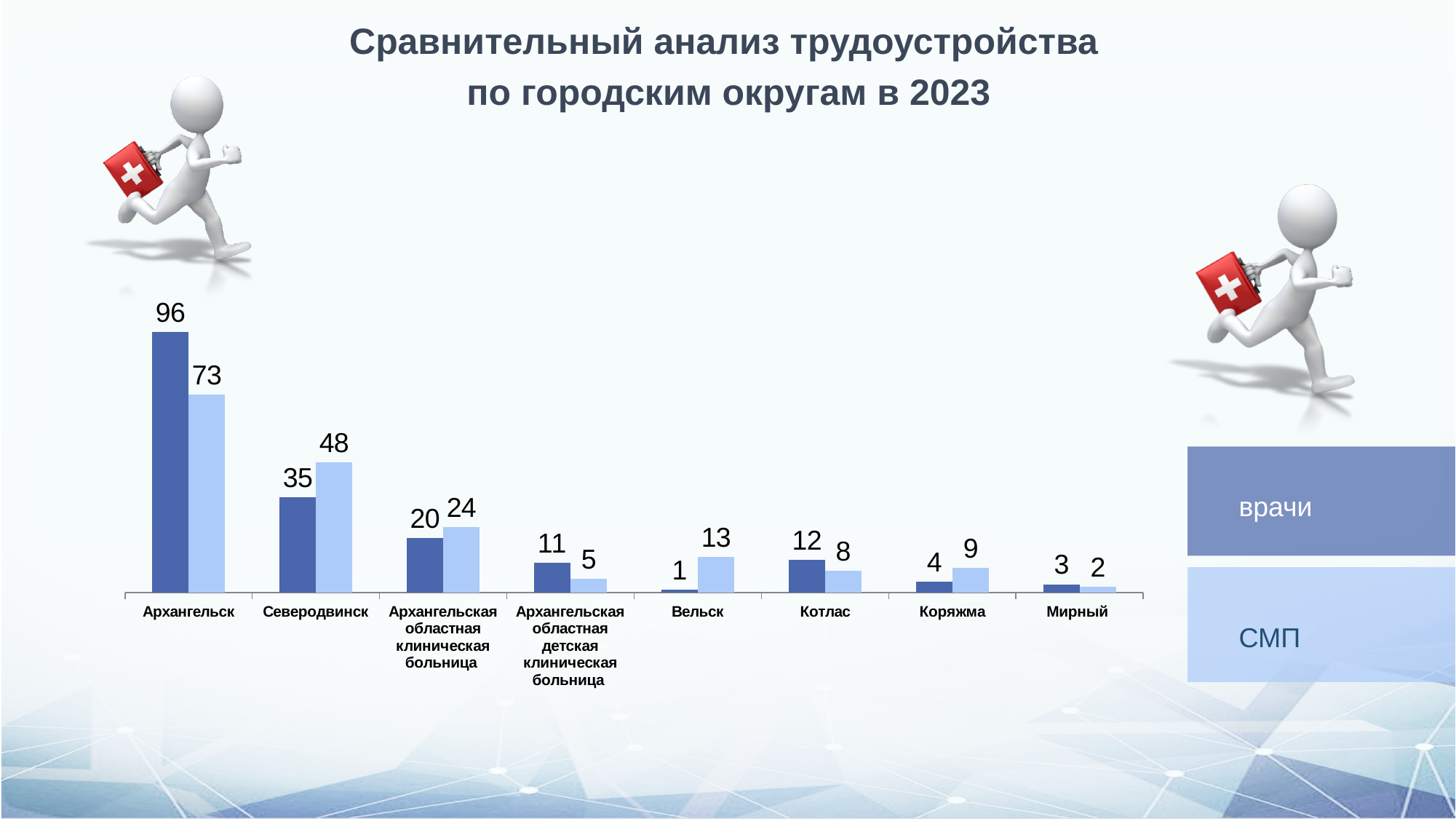
Which category has the highest value for врачи? Архангельск What is the title of the slide? Сравнительный анализ трудоустройства по городским округам в 2023 How many categories are shown on the x axis? 8 Which category has the lowest value for СМП? Мирный In Коряжма, which is larger: врачи or СМП? СМП What kind of chart is shown on the slide? Bar chart What is the value for СМП in Вельск? 13 What is the value for СМП in Северодвинск? 48 What is the value for врачи in Архангельск? 96 How many series does the chart show? 2 What is the value for врачи in Котлас? 12 What is the difference between the врачи and СМП values in Архангельск? 23